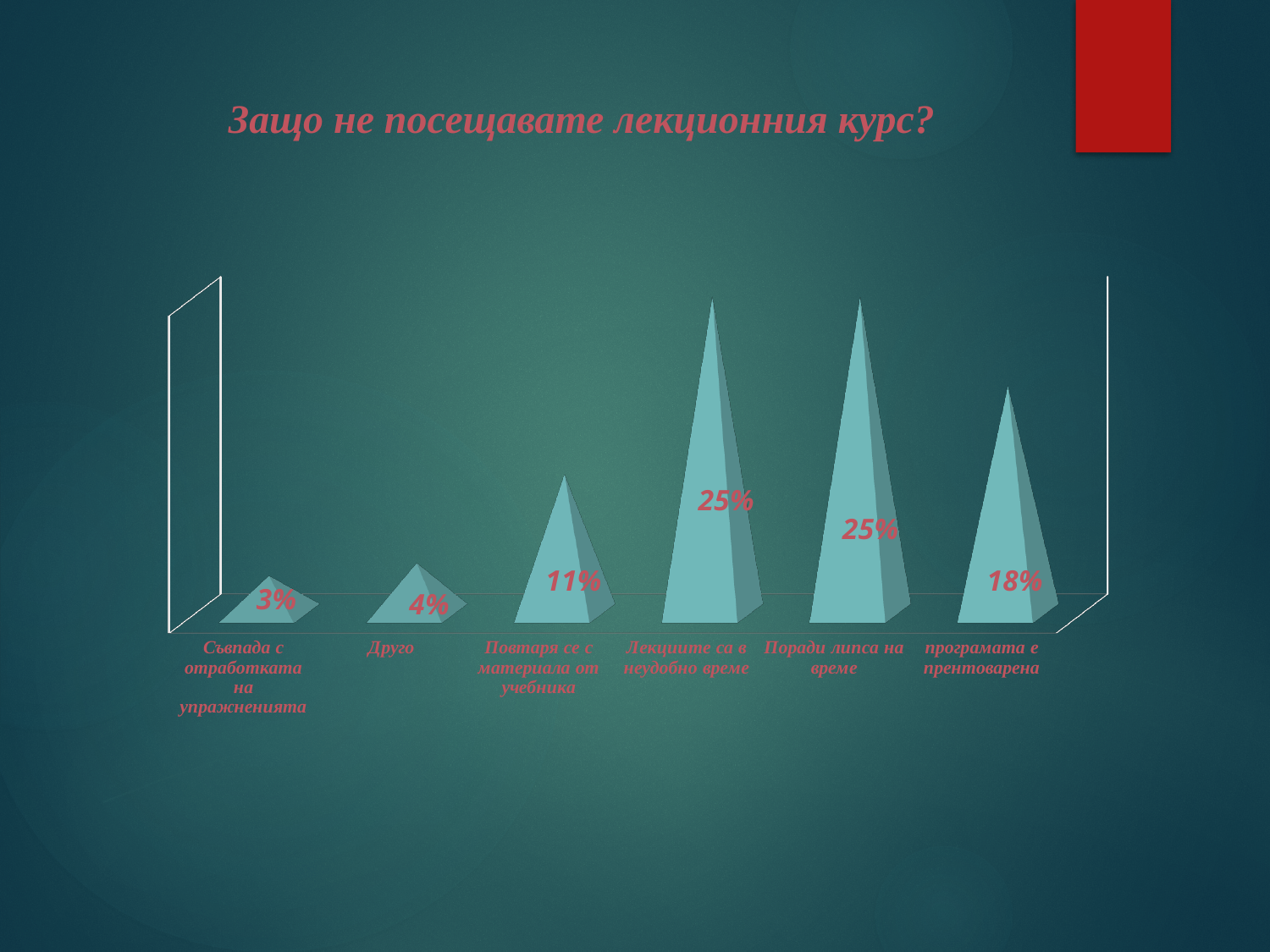
What kind of chart is shown on the slide? Bar chart What is the difference between the values for "Поради липса на време" and "програмата е прентоварена"? 7% Which category has the lowest value? Съвпада с отработката на упражненията What is the value for "Лекциите са в неудобно време"? 25% What is the value for "Повтаря се с материала от учебника"? 11% What is the difference between the values for "Повтаря се с материала от учебника" and "Друго"? 7% What is the value for "програмата е прентоварена"? 18% How many categories are shown in the chart? 6 What is the title of the chart? Защо не посещавате лекционния курс? Which is larger, the value for "програмата е прентоварена" or the value for "Повтаря се с материала от учебника"? програмата е прентоварена What is the value for "Друго"? 4% What is the value for "Съвпада с отработката на упражненията"? 3%